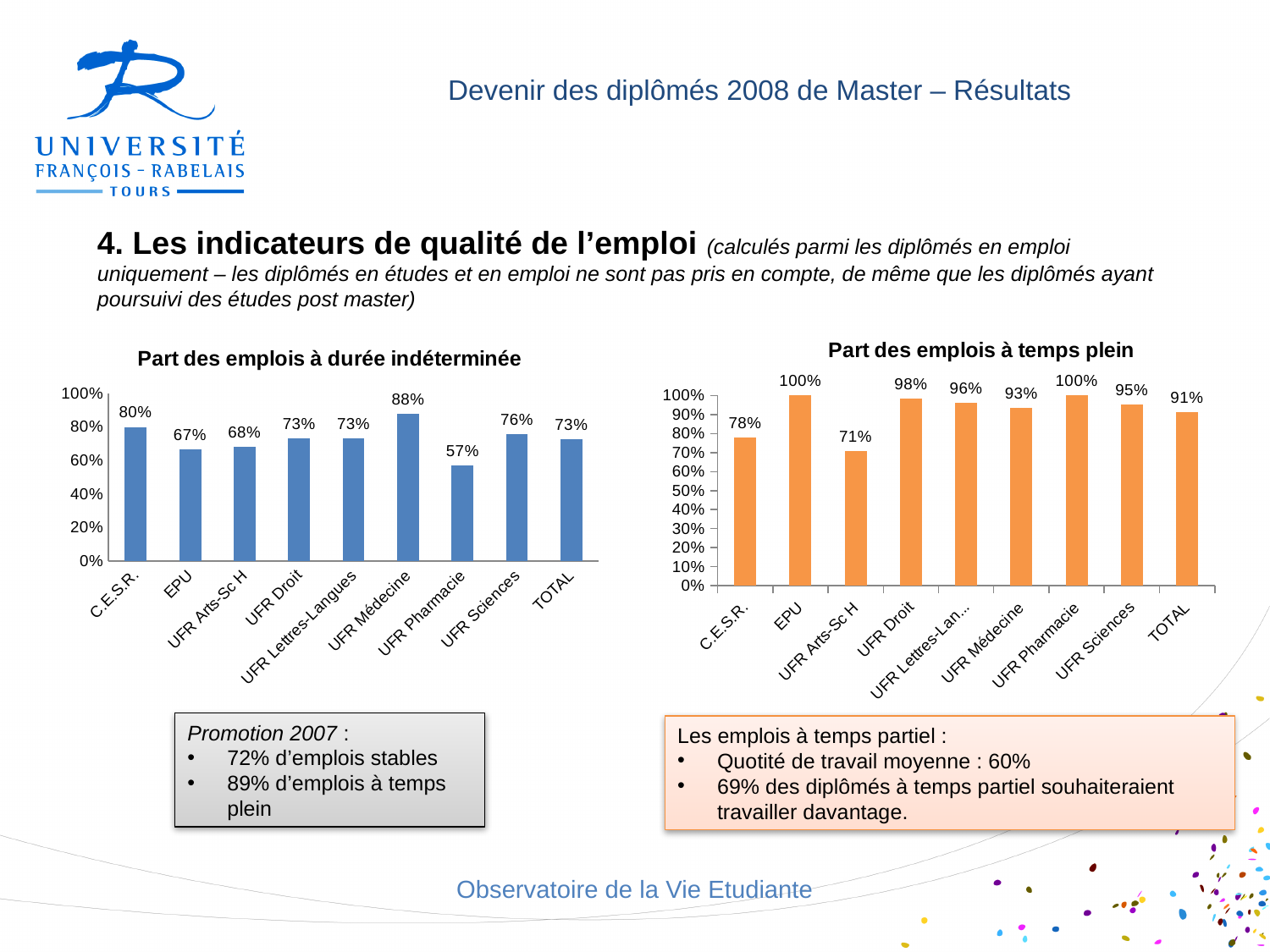
In the chart 'Part des emplois à temps plein', which category has the lowest value? UFR Arts-Sc H How many categories are shown in the chart 'Part des emplois à temps plein'? 9 In the chart 'Part des emplois à durée indéterminée', what is the value for UFR Médecine? 88% What kind of chart is 'Part des emplois à durée indéterminée'? Bar chart What colour are the bars in the chart 'Part des emplois à temps plein'? Orange In the chart 'Part des emplois à temps plein', which is larger, the value for C.E.S.R. or the value for UFR Droit? UFR Droit In the chart 'Part des emplois à durée indéterminée', which category has the highest value? UFR Médecine In the chart 'Part des emplois à durée indéterminée', which category has the lowest value? UFR Pharmacie In the chart 'Part des emplois à durée indéterminée', what is the value for TOTAL? 73% In the chart 'Part des emplois à temps plein', what is the value for UFR Arts-Sc H? 71% In the chart 'Part des emplois à durée indéterminée', what is the difference between the values for C.E.S.R. and EPU? 13% In the chart 'Part des emplois à temps plein', what is the difference between the values for EPU and TOTAL? 9%